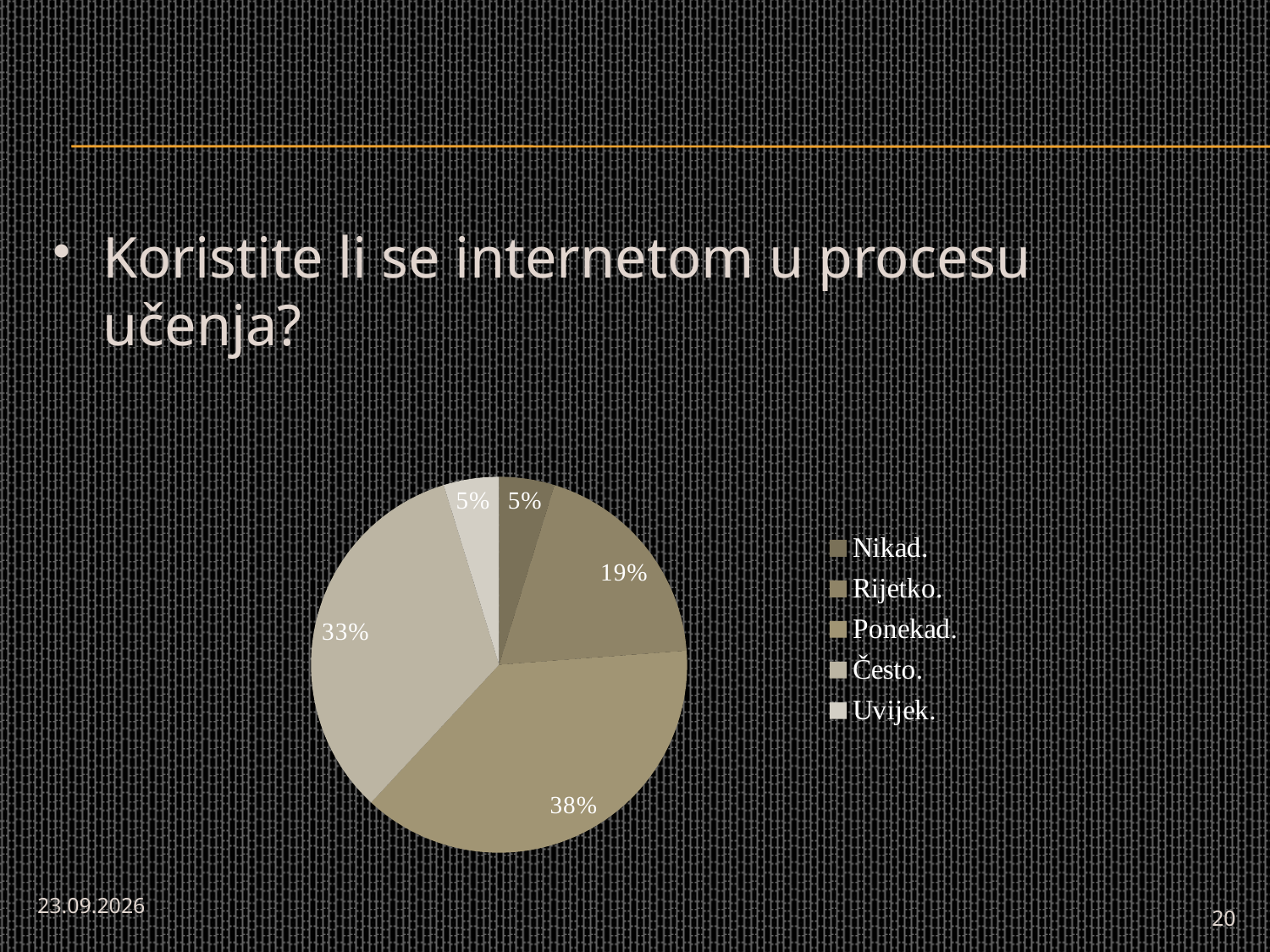
Which is larger, the share for Često. or the share for Rijetko.? Često. What question is the chart on the slide about? Koristite li se internetom u procesu učenja? Which category has the largest slice of the pie? Ponekad. What share of the pie does Često. have? 33% What is the difference in percentage points between Ponekad. and Rijetko.? 19 What kind of chart is shown on the slide? pie chart How many categories does the legend list? 5 What share of the pie does Rijetko. have? 19% What share of the pie does Nikad. have? 5% What is the difference in percentage points between Često. and Uvijek.? 28 Which legend entry is listed last? Uvijek.